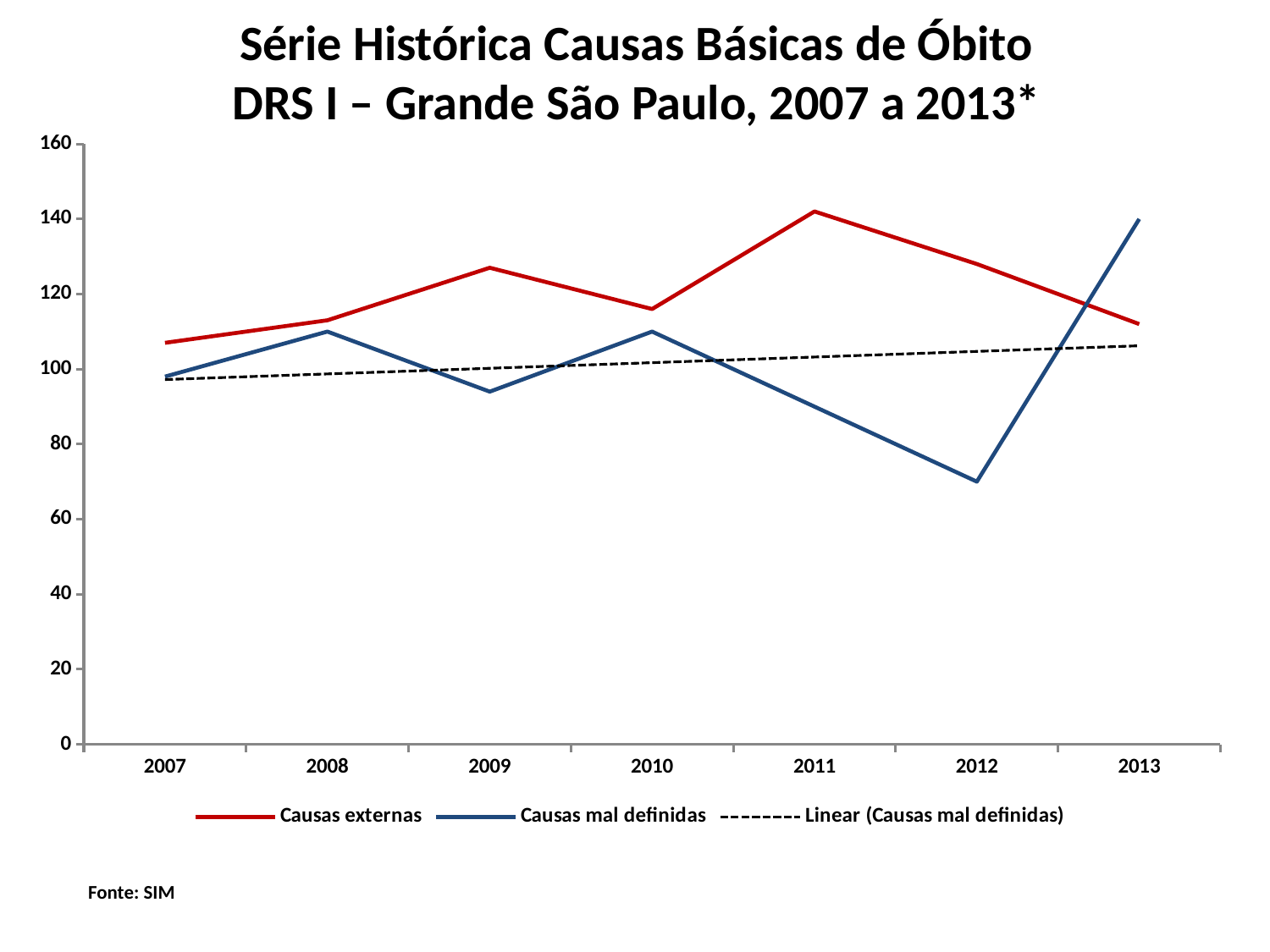
Does the Causas mal definidas series rise or fall from 2010 to 2012? fall Is the value for Causas mal definidas in 2012 greater or less than 80? less In which year does the Causas mal definidas series reach its lowest value? 2012 In which year does the Causas externas series reach its highest value? 2011 In 2013, which series has the larger value, Causas externas or Causas mal definidas? Causas mal definidas In 2012, which series has the larger value, Causas externas or Causas mal definidas? Causas externas How many years are plotted along the x axis? 7 What kind of chart is shown on the slide? line chart How many series does the legend list? 3 In which year does the Causas mal definidas series reach its highest value? 2013 Is the value for Causas externas in 2009 greater or less than 120? greater Is the value for Causas mal definidas in 2013 greater or less than 120? greater